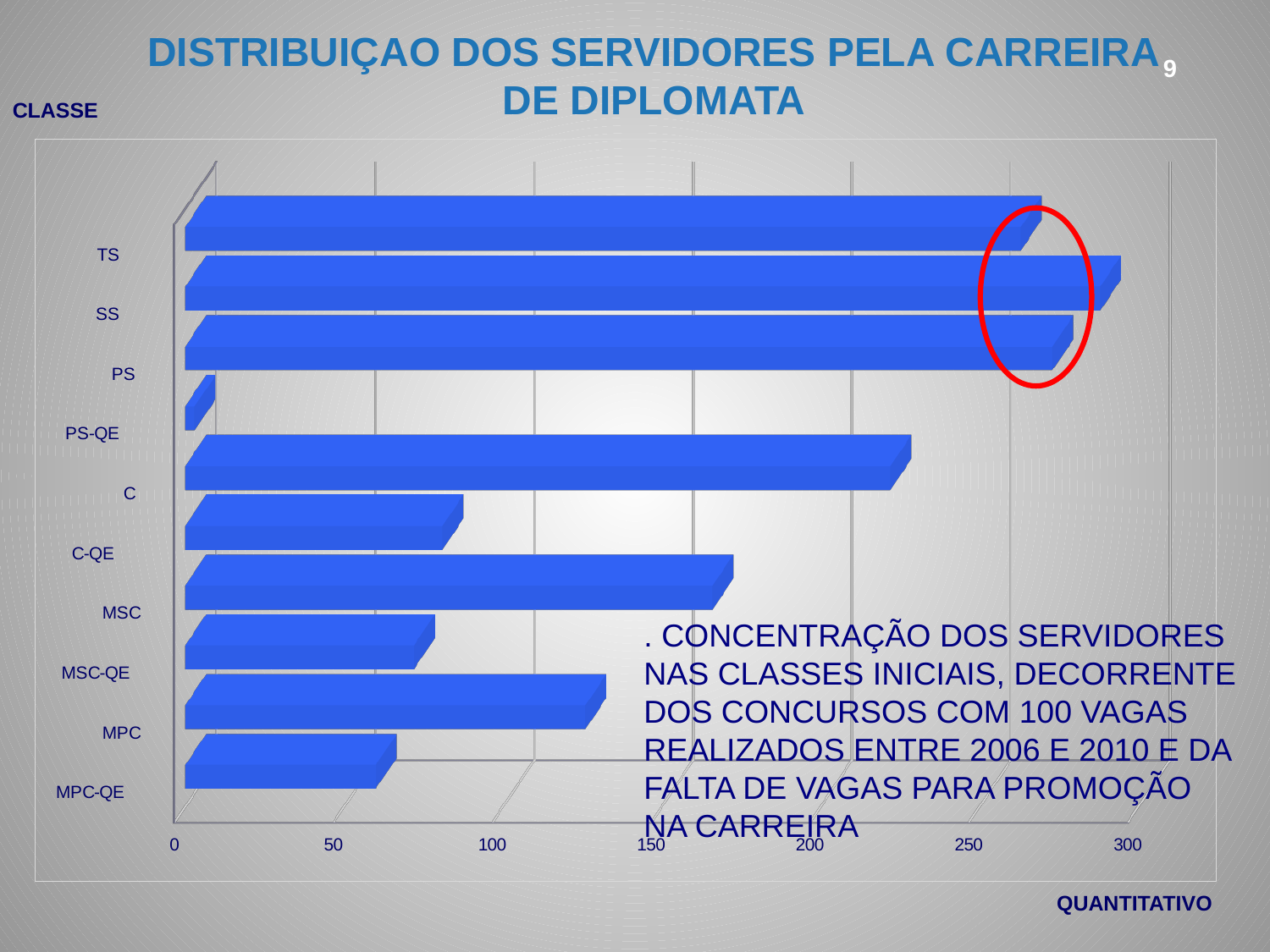
Is the value for C-QE greater or less than 100? less What kind of chart is shown on the slide? bar chart Which class has the lowest value in the chart? PS-QE Is the value for MPC greater or less than 100? greater Is the value for C greater or less than 200? greater Which class has the highest value in the chart? SS How many classes (categories) are plotted in the chart? 10 Which has the larger value, SS or TS? SS What is the label shown for the horizontal (value) axis of the chart? QUANTITATIVO Which has the larger value, MSC or MPC? MSC